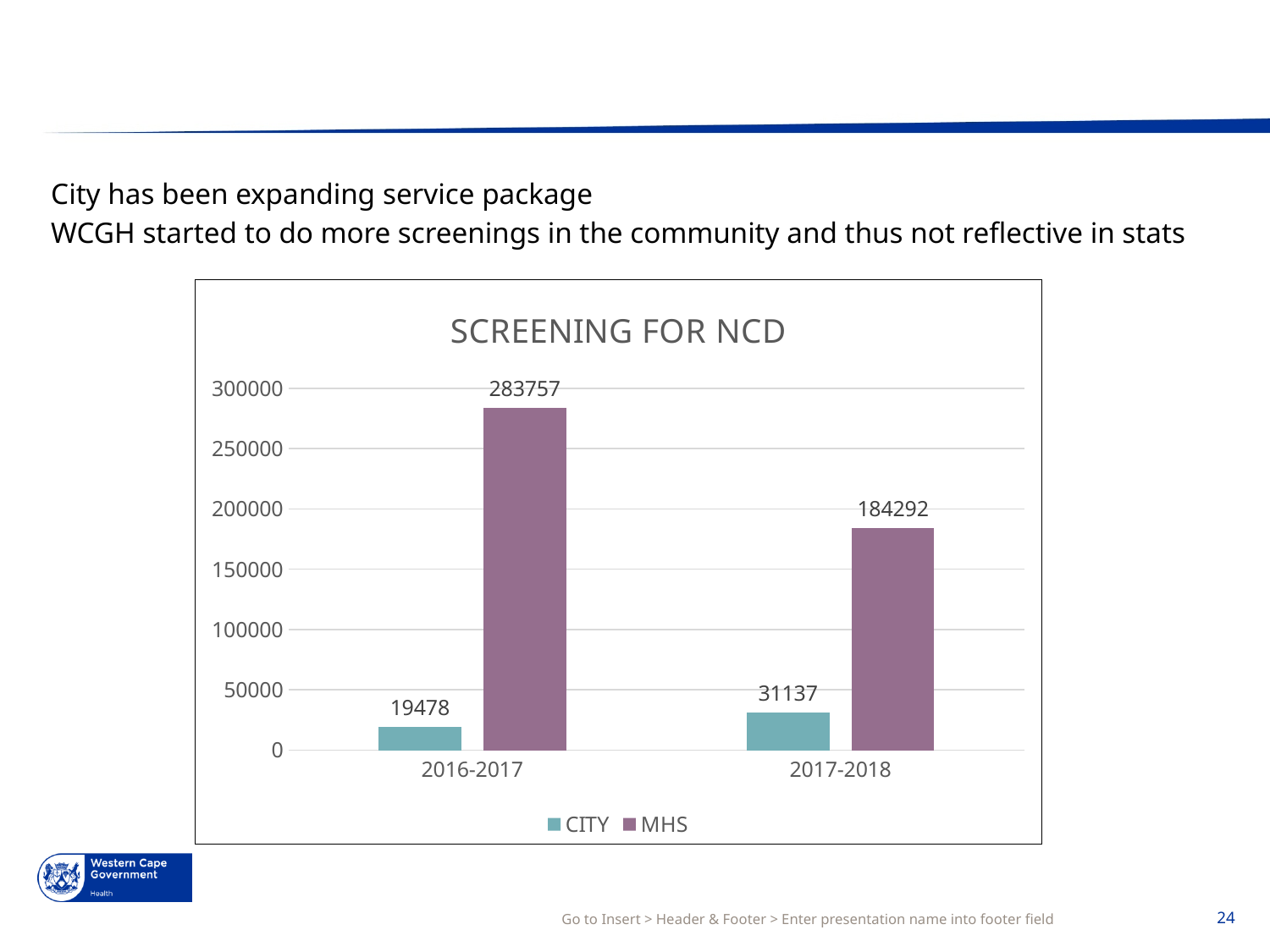
Which series has the highest value in 2016-2017? MHS How many series does the legend list? 2 What is the value for MHS in 2017-2018? 184292 What is the title of the chart? SCREENING FOR NCD What kind of chart is shown? bar chart Which bar has the lowest value on the chart? CITY in 2016-2017 What is the value for CITY in 2017-2018? 31137 What is the value for CITY in 2016-2017? 19478 What is the difference between the CITY values for 2017-2018 and 2016-2017? 11659 What is the value for MHS in 2016-2017? 283757 Is the CITY value for 2017-2018 larger or smaller than the CITY value for 2016-2017? larger What is the difference between the MHS values for 2016-2017 and 2017-2018? 99465